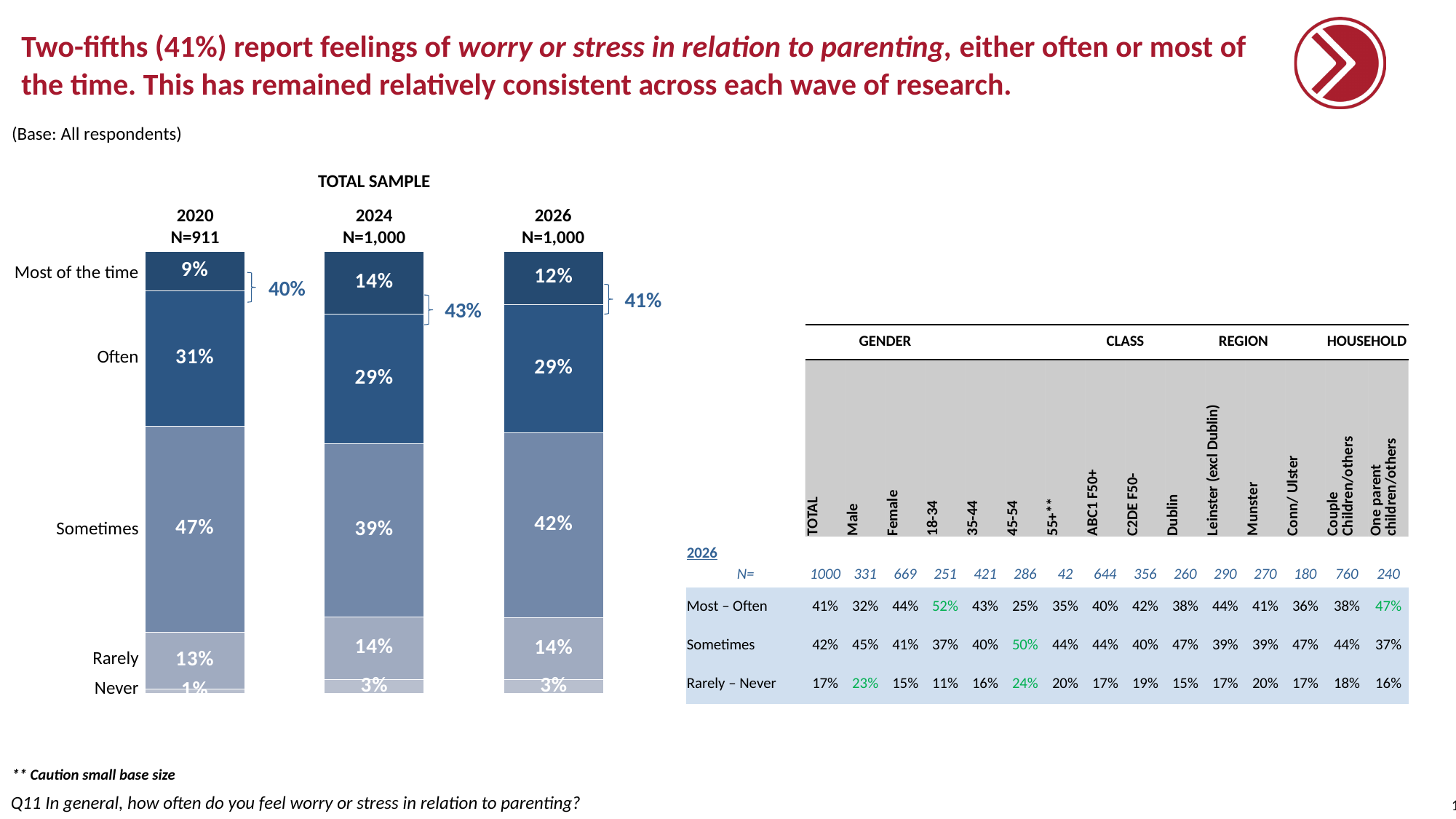
In the TOTAL SAMPLE chart, what is the 'Never' value for 2020? 1% In the TOTAL SAMPLE chart, what combined percentage is shown by the bracket for 'Most of the time' plus 'Often' in 2024? 43% In the TOTAL SAMPLE chart, what is the difference between the 'Sometimes' values for 2020 and 2024? 8 percentage points In the TOTAL SAMPLE chart, what is the 'Often' value for 2024? 29% In the TOTAL SAMPLE chart, which year has the highest 'Most of the time' value? 2024 In the TOTAL SAMPLE chart, what percentage said 'Sometimes' in 2020? 47% In the TOTAL SAMPLE chart, what percentage of respondents in 2026 said they feel worry or stress 'Most of the time'? 12% What is the sample size (N) shown for the 2020 bar in the TOTAL SAMPLE chart? N=911 In the TOTAL SAMPLE chart, is the 'Rarely' value larger in 2020 or in 2026? 2026 What kind of chart is shown under the heading TOTAL SAMPLE? Stacked bar chart In the TOTAL SAMPLE chart, which year has the lowest 'Sometimes' value? 2024 How many bars (years) are shown in the TOTAL SAMPLE chart? 3